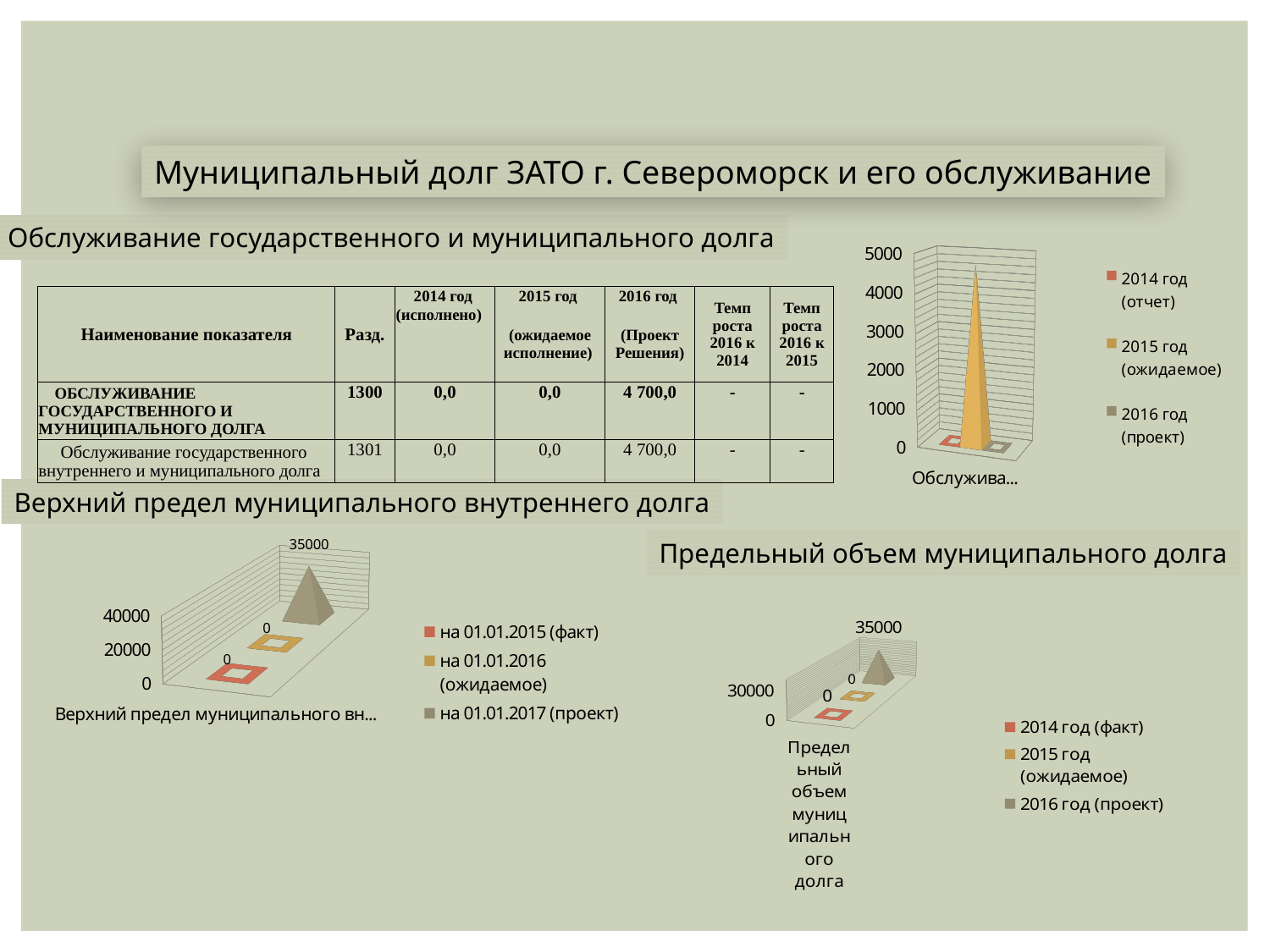
In the chart titled Предельный объем муниципального долга, which series has the highest value? 2016 год (проект) In the chart titled Предельный объем муниципального долга, what is the value for 2016 год (проект)? 35000 How many series does the legend of the top-right chart (Обслуживание...) list? 3 In the bottom-left chart (Верхний предел муниципального внутреннего долга), what is the value for на 01.01.2017 (проект)? 35000 In the top-right chart (Обслуживание...), is the value for 2016 год (проект) greater or less than 3000? less In the top-right chart (Обслуживание...), which series has the highest value? 2015 год (ожидаемое) What is the highest value shown on the vertical axis of the top-right chart (Обслуживание...)? 5000 How many series does the legend of the bottom-left chart (Верхний предел муниципального внутреннего долга) list? 3 In the bottom-left chart (Верхний предел муниципального внутреннего долга), what is the value for на 01.01.2015 (факт)? 0 In the chart titled Предельный объем муниципального долга, what is the value for 2015 год (ожидаемое)? 0 In the bottom-left chart (Верхний предел муниципального внутреннего долга), which series has the highest value? на 01.01.2017 (проект) In the chart titled Предельный объем муниципального долга, what is the difference between the values for 2016 год (проект) and 2014 год (факт)? 35000